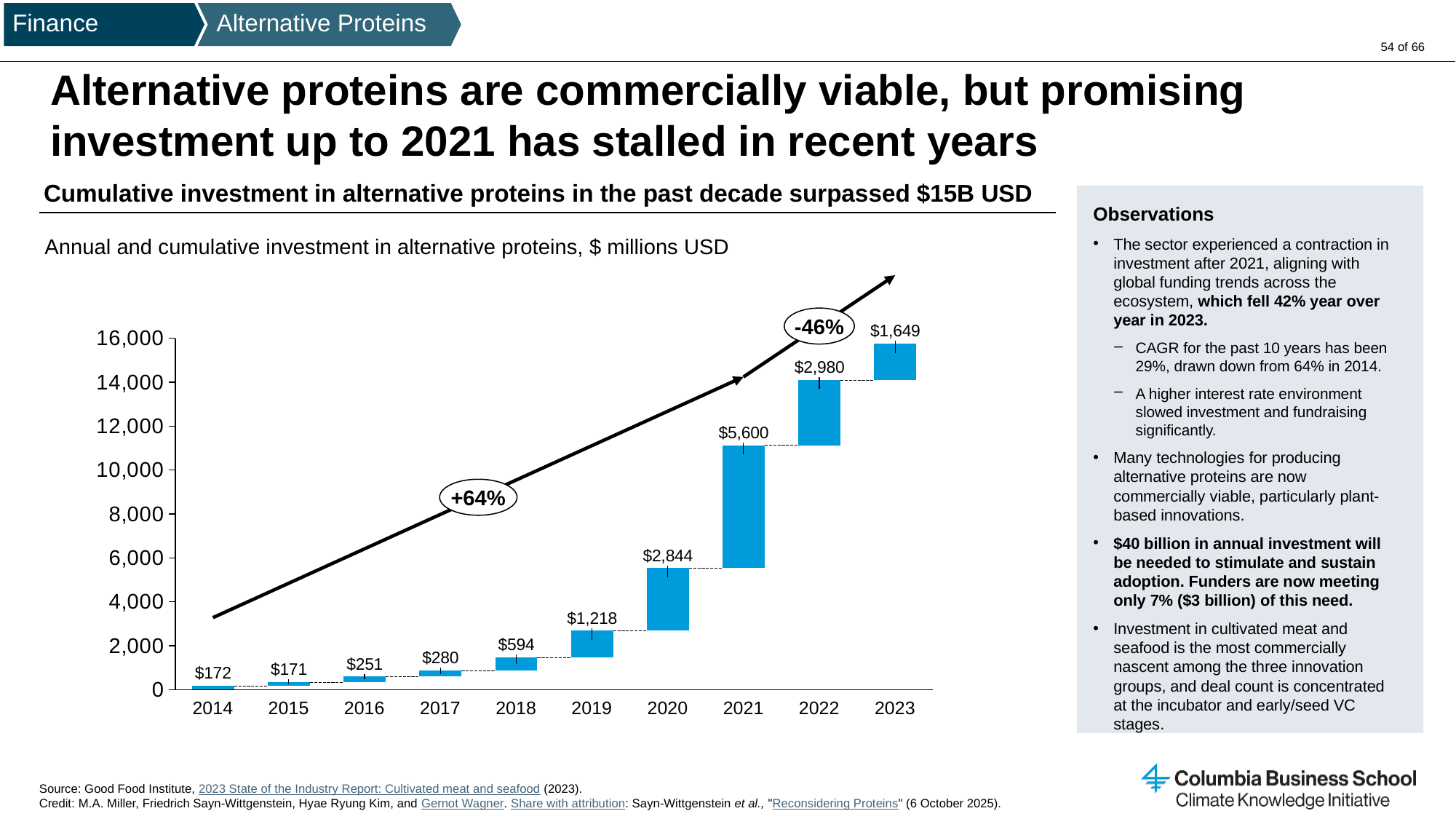
What is the difference between the annual investment values for 2021 and 2022? $2,620 What is the annual investment value shown for 2023? $1,649 Which year has the lowest annual investment value? 2015 Which year has the highest annual investment value? 2021 What percentage change is shown in the annotation near the top right of the chart, between 2021 and 2023? -46% What is the annual investment value shown for 2021? $5,600 How many years are shown on the x axis of the chart? 10 Do the annual investment values rise or fall from 2014 to 2021? Rise Which year has a larger annual investment value, 2020 or 2022? 2022 What is the annual investment value shown for 2014? $172 What kind of chart is used to show annual and cumulative investment? Bar chart What unit is stated in the chart subtitle for the investment values? $ millions USD